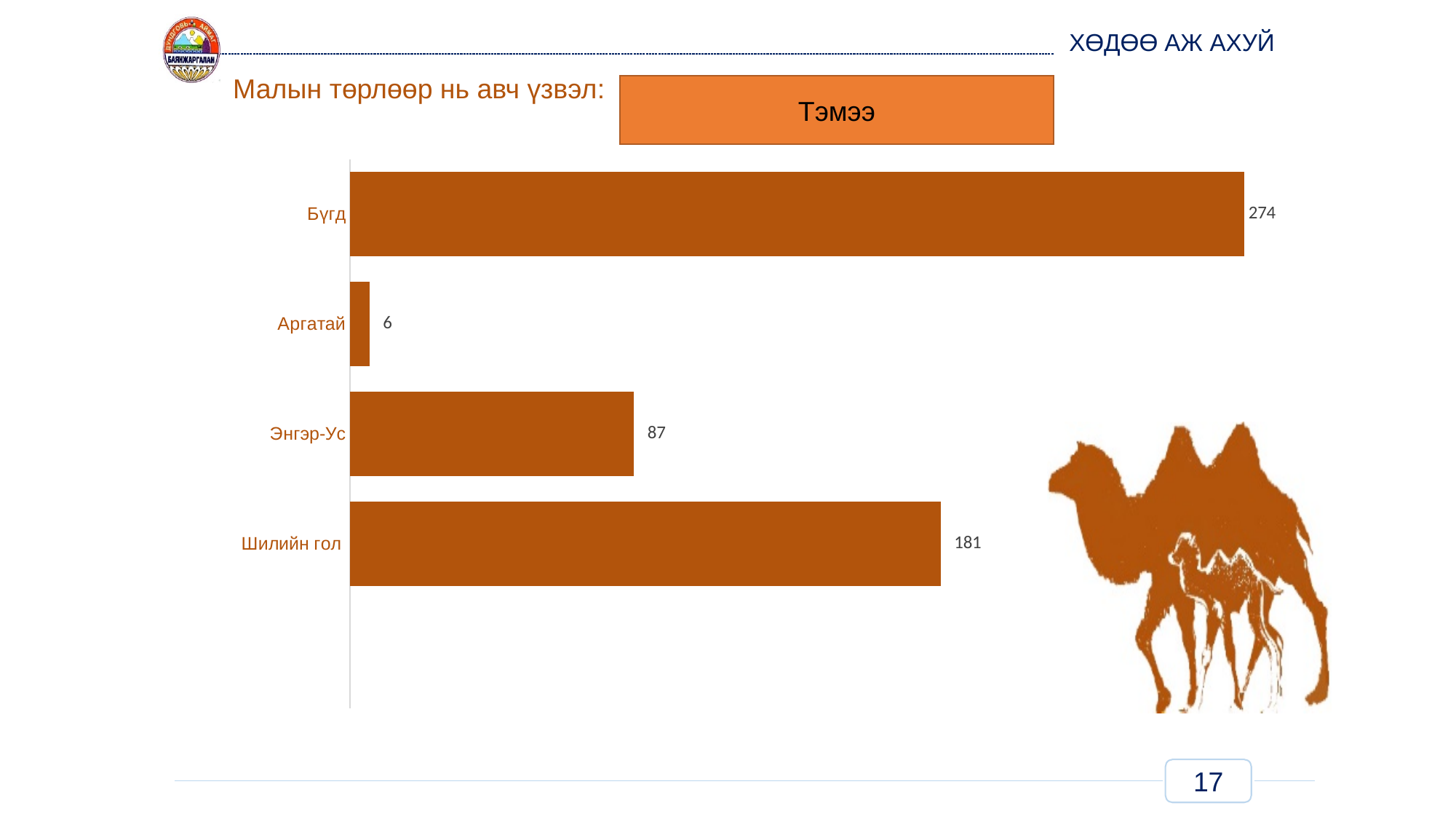
What is the value for Бүгд? 274 Which is larger, the value for Шилийн гол or the value for Энгэр-Ус? Шилийн гол What is the value for Шилийн гол? 181 Which category has the highest value? Бүгд What is the difference between the values for Шилийн гол and Энгэр-Ус? 94 What is the title shown in the orange box above the chart? Тэмээ What is the difference between the values for Энгэр-Ус and Аргатай? 81 Which category has the lowest value? Аргатай What is the value for Аргатай? 6 How many categories are shown in the chart? 4 What is the value for Энгэр-Ус? 87 What kind of chart is shown on the slide? Bar chart